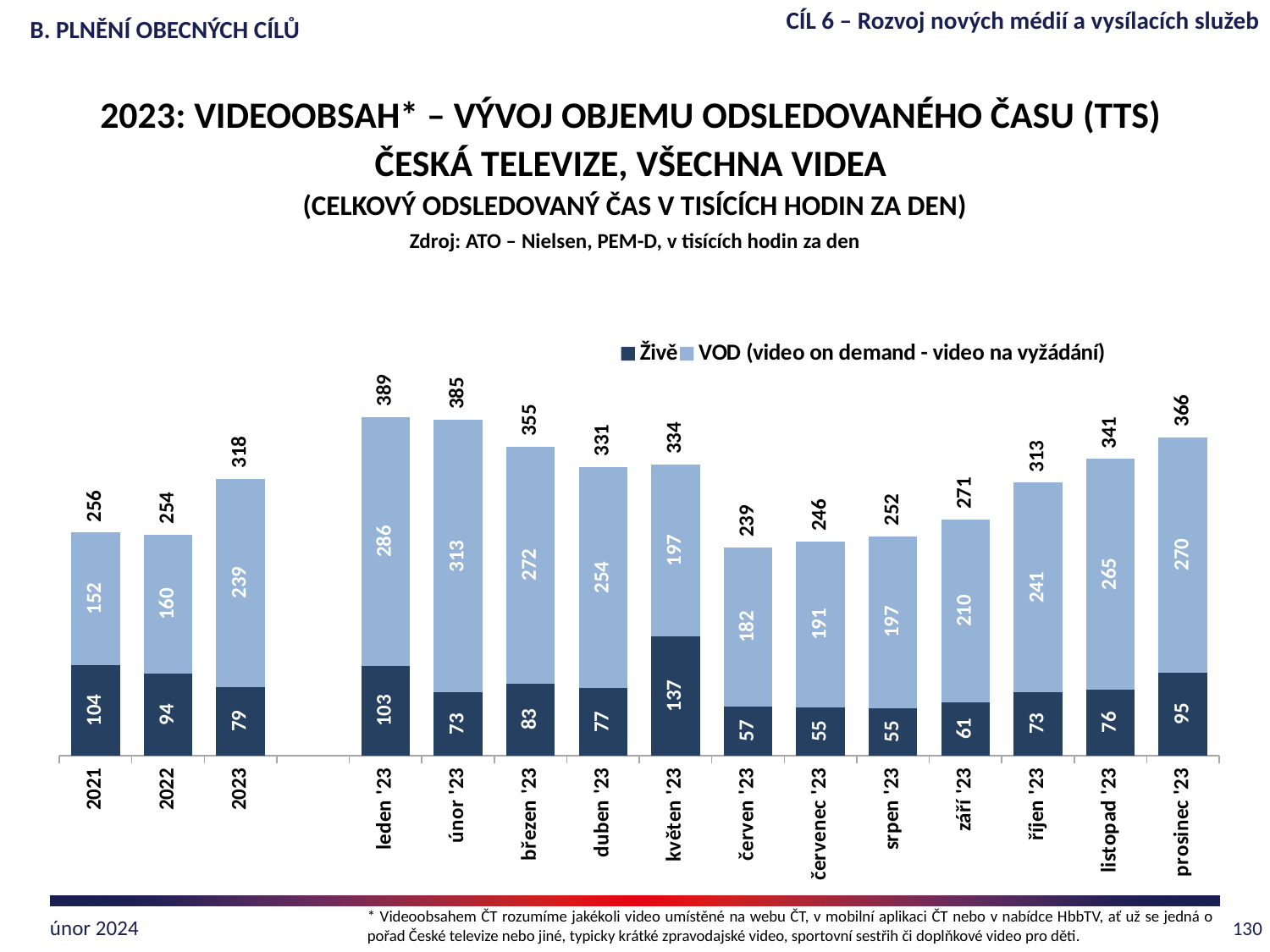
What is the Živě value for 2021? 104 What is the VOD value for únor '23? 313 What type of chart is shown on the slide? stacked bar chart Which month of 2023 has the lowest total? červen '23 What is the Živě value for září '23? 61 Which month of 2023 has the highest total? leden '23 What is the total of the stacked bar for prosinec '23? 366 Is the VOD value larger for březen '23 or duben '23? březen '23 How many bars are plotted in the chart? 15 How many series does the legend list? 2 What is the difference between the totals for 2023 and 2022? 64 Which month of 2023 has the highest Živě value? květen '23